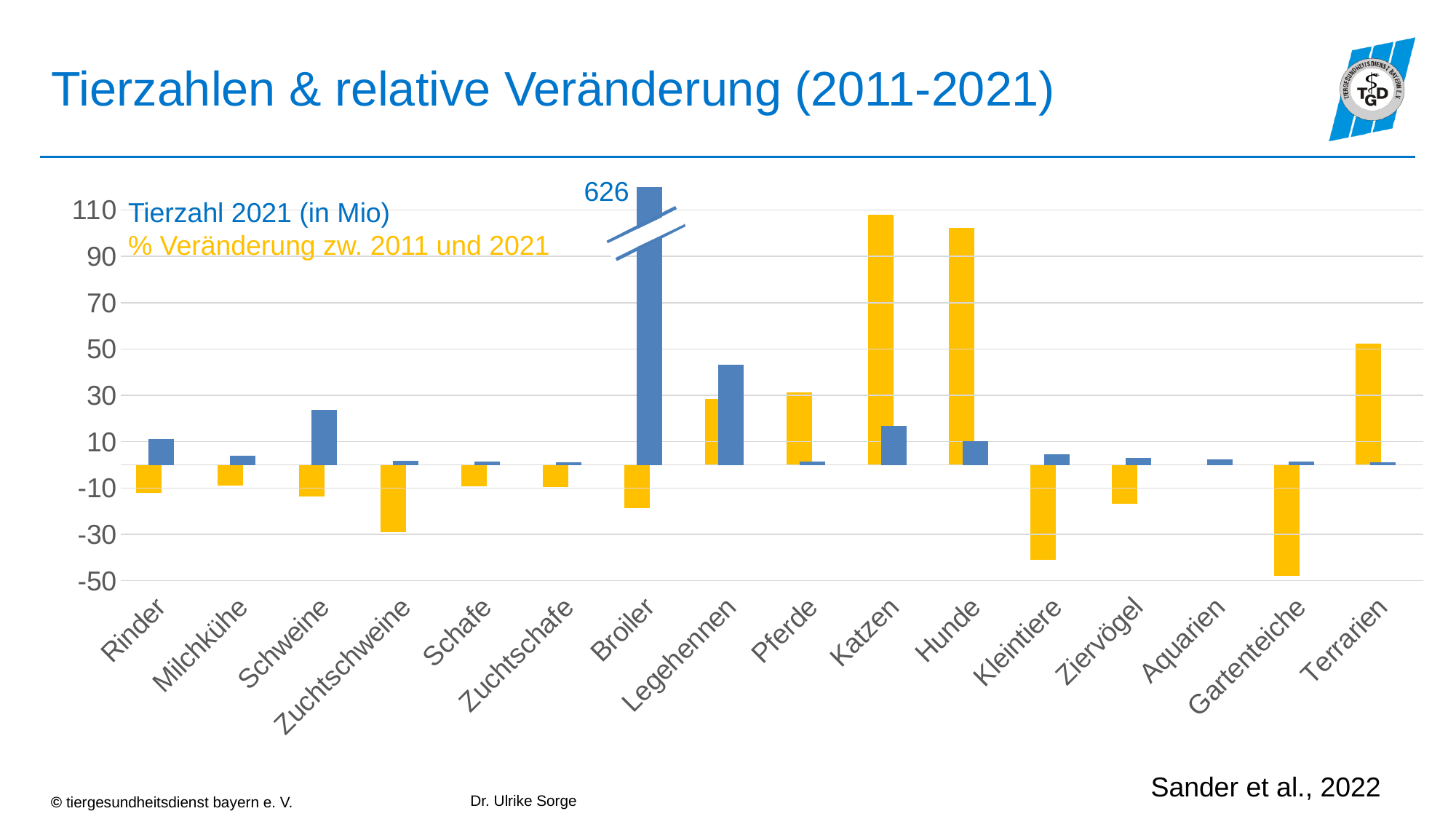
What type of chart is shown on the slide? Bar chart Is the % Veränderung zw. 2011 und 2021 for Kleintiere greater or less than -30? less Which has the larger Tierzahl 2021 (in Mio), Katzen or Hunde? Katzen Which has the larger Tierzahl 2021 (in Mio), Schweine or Rinder? Schweine How many data series does the chart show? 2 Which category has the lowest % Veränderung zw. 2011 und 2021? Gartenteiche Is the % Veränderung zw. 2011 und 2021 for Katzen greater or less than 90? greater How many categories are shown on the x axis of the chart? 16 What is the Tierzahl 2021 (in Mio) value shown for Broiler? 626 Is the Tierzahl 2021 (in Mio) for Legehennen greater or less than 30? greater Which category has the highest Tierzahl 2021 (in Mio)? Broiler